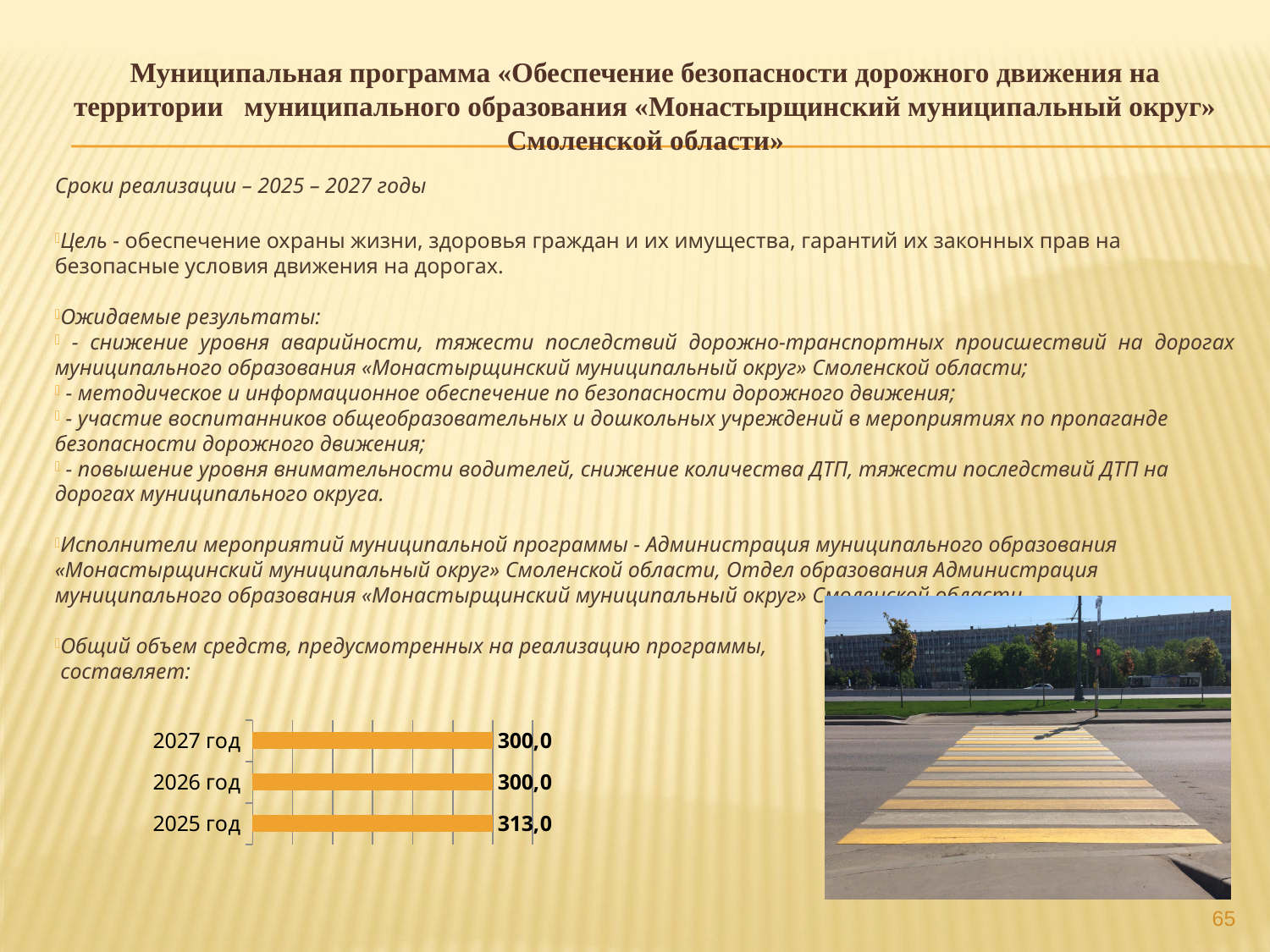
How many years (categories) are shown in the chart? 3 What is the value shown for 2027 год? 300,0 Are the values for 2026 год and 2027 год equal? Yes What colour are the bars in the chart? Orange What kind of chart is shown on the slide? Bar chart What is the difference between the values for 2025 год and 2026 год? 13,0 Which is larger, the value for 2025 год or the value for 2027 год? 2025 год What is the value shown for 2025 год? 313,0 What is the value shown for 2026 год? 300,0 Does the value decrease or increase from 2025 год to 2026 год? Decrease Which year has the highest value in the chart? 2025 год